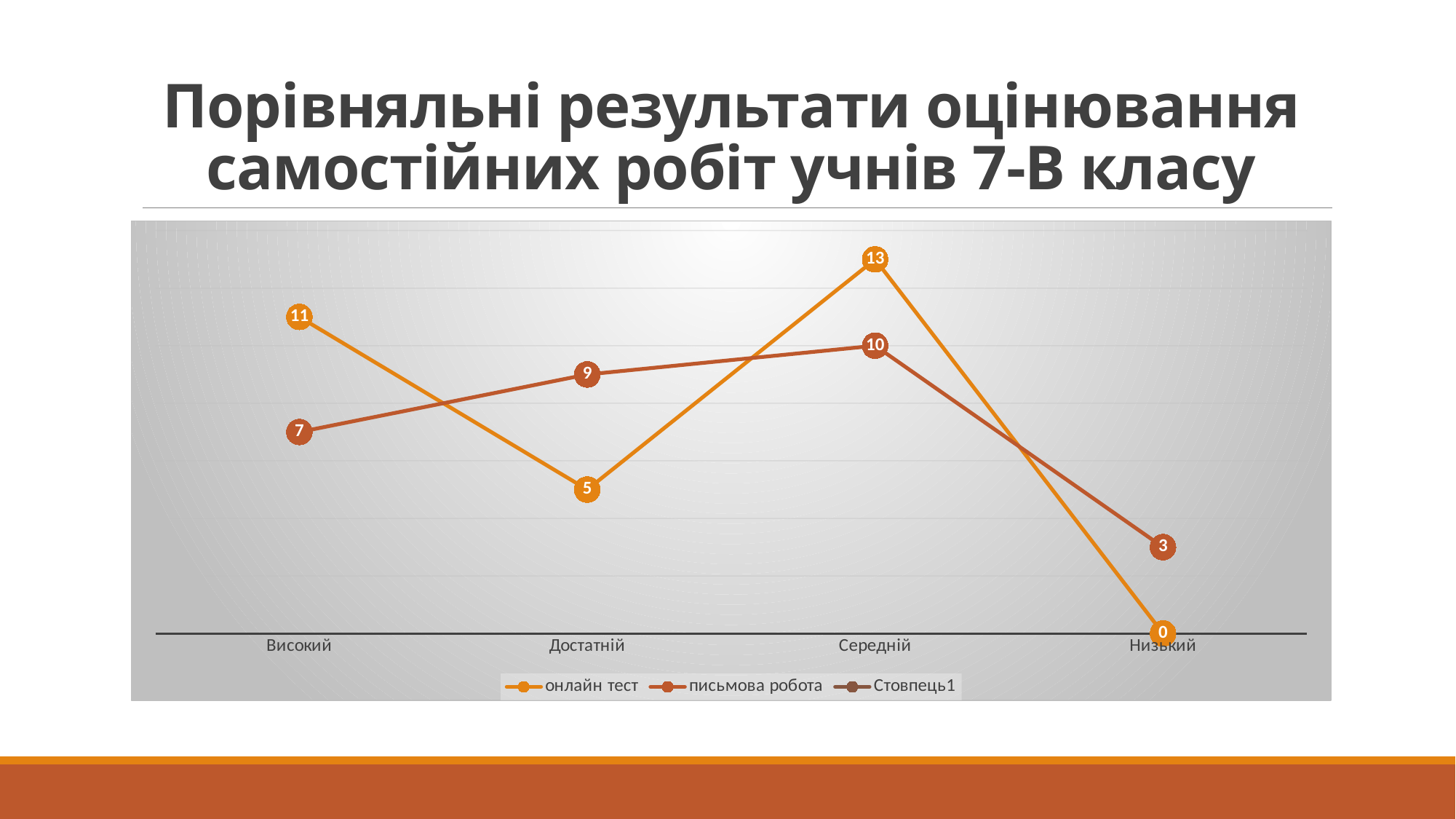
How many categories are shown on the x axis? 4 Which category has the lowest value for "письмова робота"? Низький What is the value for "письмова робота" at "Достатній"? 9 What is the value for "онлайн тест" at "Низький"? 0 What is the title of the slide? Порівняльні результати оцінювання самостійних робіт учнів 7-В класу What is the value for "онлайн тест" at "Високий"? 11 What type of chart is shown on the slide? line chart What is the difference between "онлайн тест" and "письмова робота" at "Середній"? 3 How many series does the legend list? 3 At "Достатній", which series has the larger value, "онлайн тест" or "письмова робота"? письмова робота Which category has the highest value for "онлайн тест"? Середній What is the value for "письмова робота" at "Середній"? 10